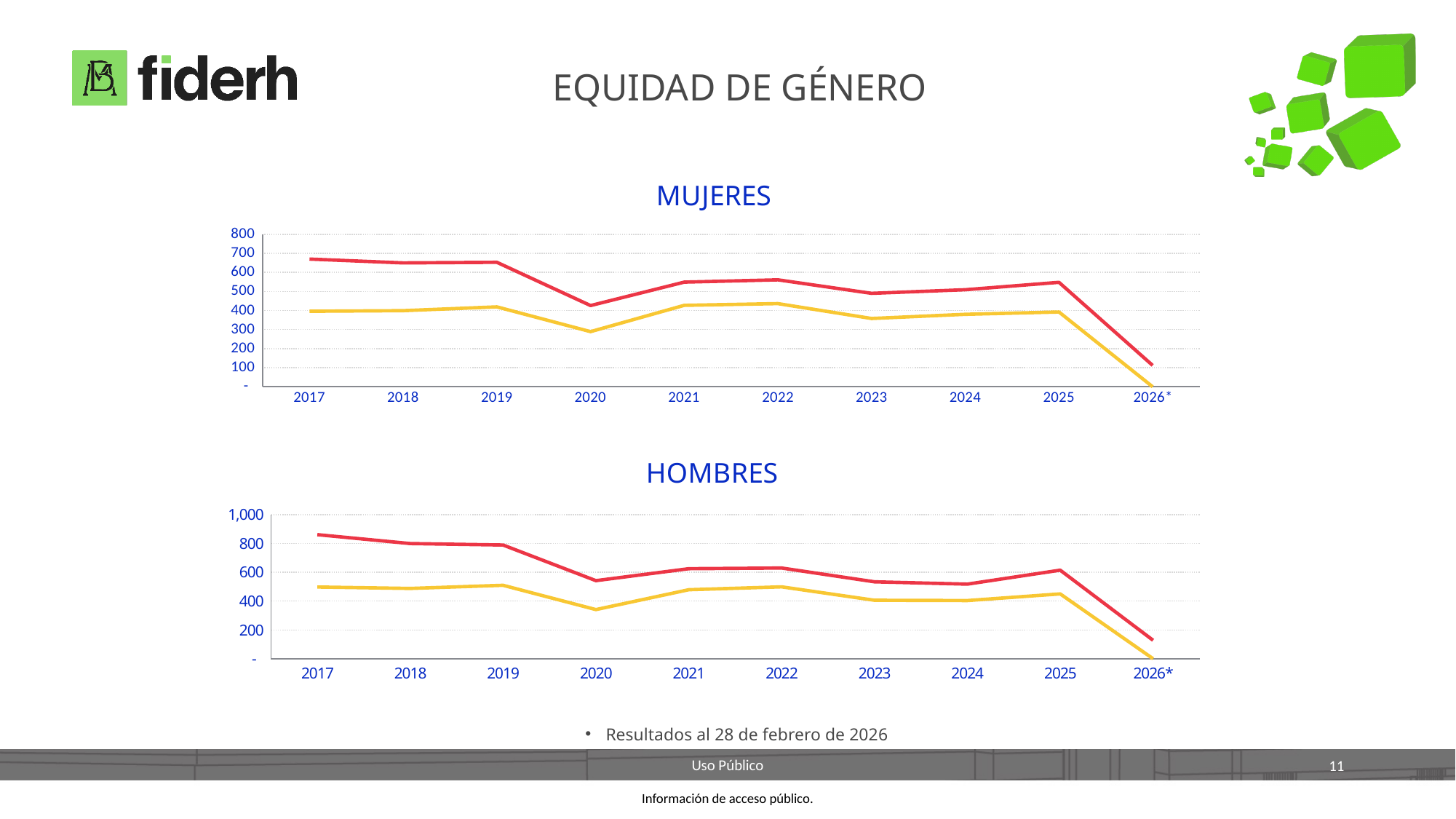
In the HOMBRES chart, which year has the highest value on the red line? 2017 What is the title of the top chart on the slide? MUJERES What kind of chart is the MUJERES chart? line chart In the HOMBRES chart, is the value of the red line for 2017 greater or less than 800? greater In the MUJERES chart, does the red line overall rise or fall from 2017 to 2026*? fall How many lines are plotted on the MUJERES chart? 2 In the HOMBRES chart, is the value of the yellow line for 2020 greater or less than 400? less In the MUJERES chart, is the value of the red line for 2017 greater or less than 600? greater In the HOMBRES chart, is the red line value higher in 2019 or in 2020? 2019 In the MUJERES chart, which year has the lowest value on the red line? 2026* How many years are shown on the x axis of the HOMBRES chart? 10